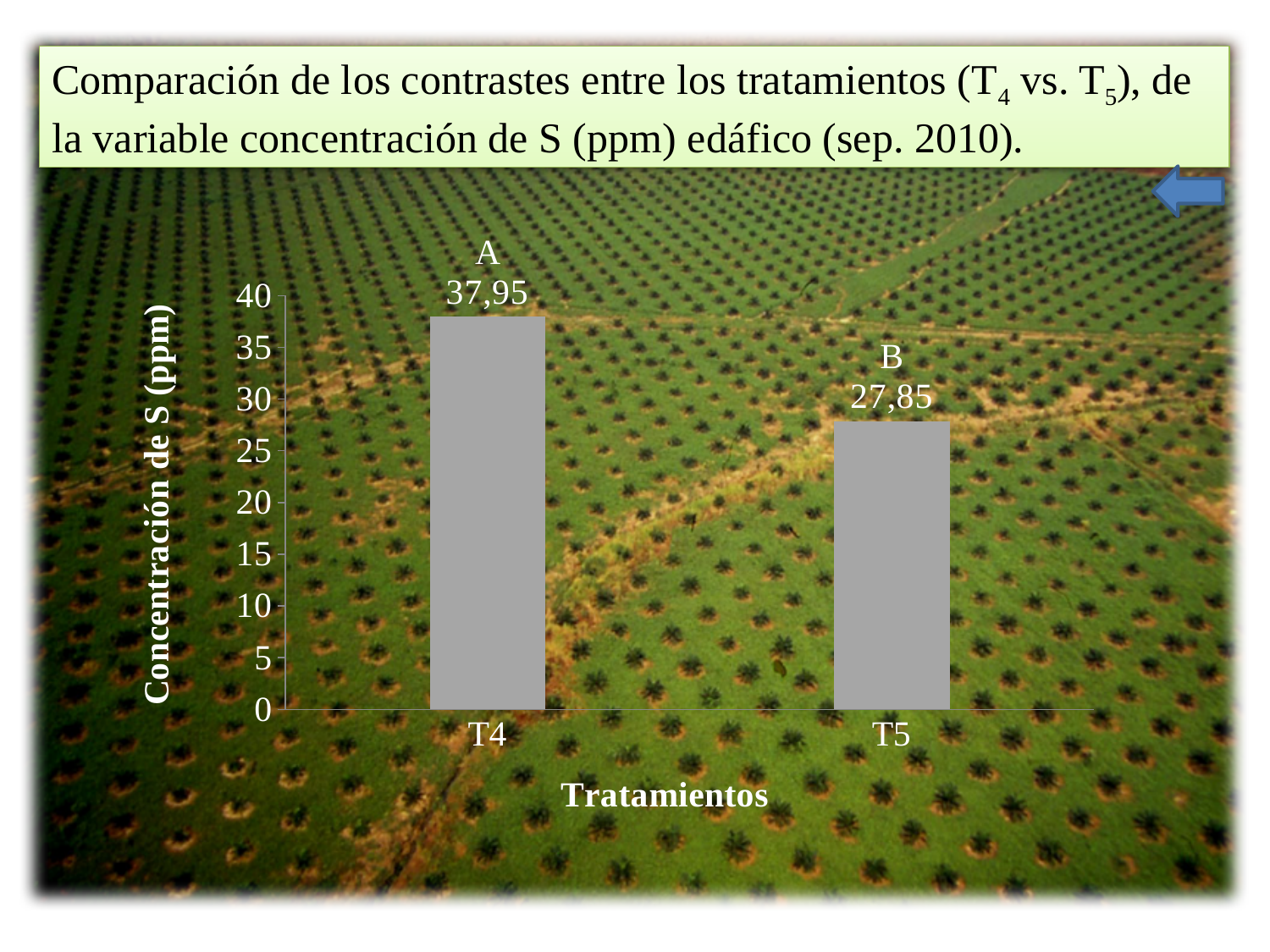
Is the value for T5 greater or less than 30? less Which treatment has the lowest S concentration? T5 How many treatments are shown in the chart? 2 What kind of chart is shown on the slide? bar chart What is the S concentration value for treatment T4? 37,95 What is the S concentration value for treatment T5? 27,85 Which treatment has the highest S concentration? T4 What is the label of the y axis? Concentración de S (ppm) What is the difference between the S concentration of T4 and T5? 10,10 Which treatment has a larger S concentration, T4 or T5? T4 What statistical group letter is shown above the T5 bar? B Is the value for T4 greater or less than 35? greater